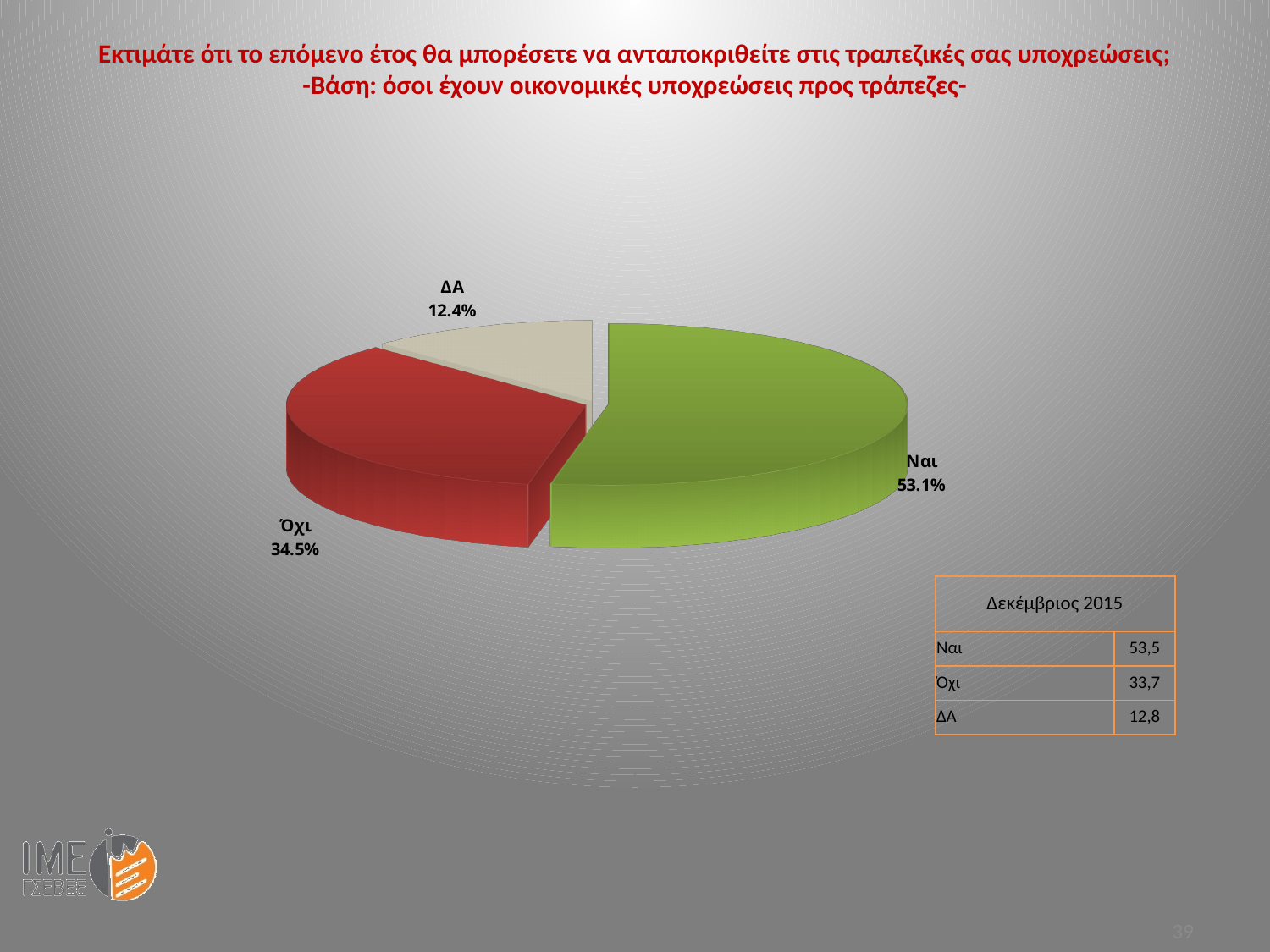
Which category has the largest slice in the pie chart? Ναι What colour is the Όχι slice of the pie chart? Red What percentage is shown for the Ναι slice of the pie chart? 53.1% How many slices does the pie chart have? 3 What percentage is shown for the Όχι slice of the pie chart? 34.5% What percentage is shown for the ΔΑ slice of the pie chart? 12.4% What is the difference in percentage points between the Όχι and ΔΑ slices? 22.1 What is the difference in percentage points between the Ναι and Όχι slices? 18.6 Which category has the smallest slice in the pie chart? ΔΑ Which slice is larger, Όχι or ΔΑ? Όχι What type of chart is shown on the slide? Pie chart What colour is the Ναι slice of the pie chart? Green